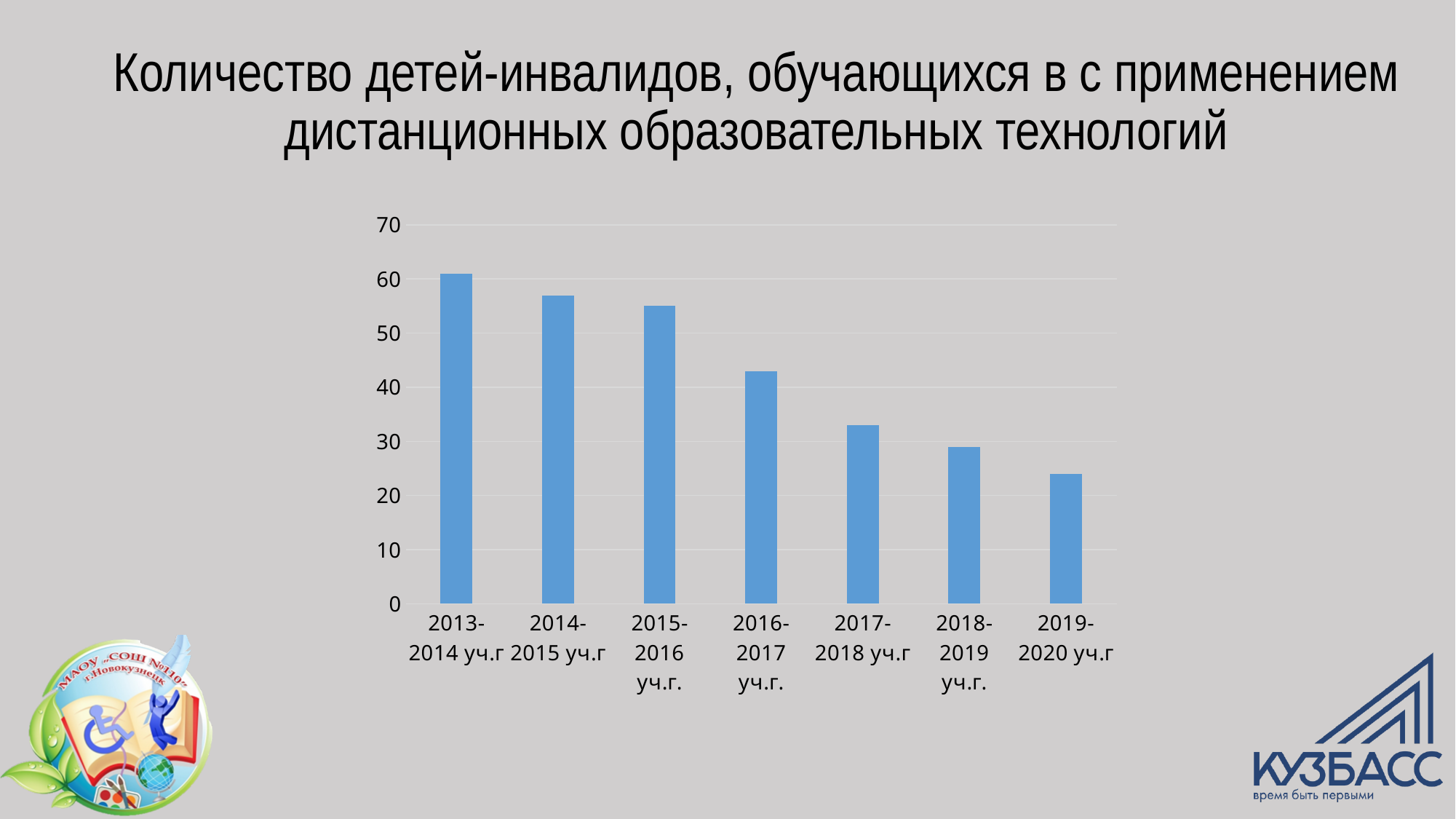
How many academic years (categories) are shown on the x axis? 7 Which academic year has the lowest value? 2019-2020 уч.г Is the value for 2016-2017 уч.г. greater or less than 40? greater Is the value for 2017-2018 уч.г greater or less than 40? less Is the value for 2014-2015 уч.г greater or less than 60? less What is the highest value shown on the vertical axis? 70 Which academic year has the highest value? 2013-2014 уч.г What kind of chart is shown on the slide? bar chart Which is larger, the value for 2015-2016 уч.г. or the value for 2018-2019 уч.г.? 2015-2016 уч.г. Do the values rise or fall from 2013-2014 to 2019-2020? fall